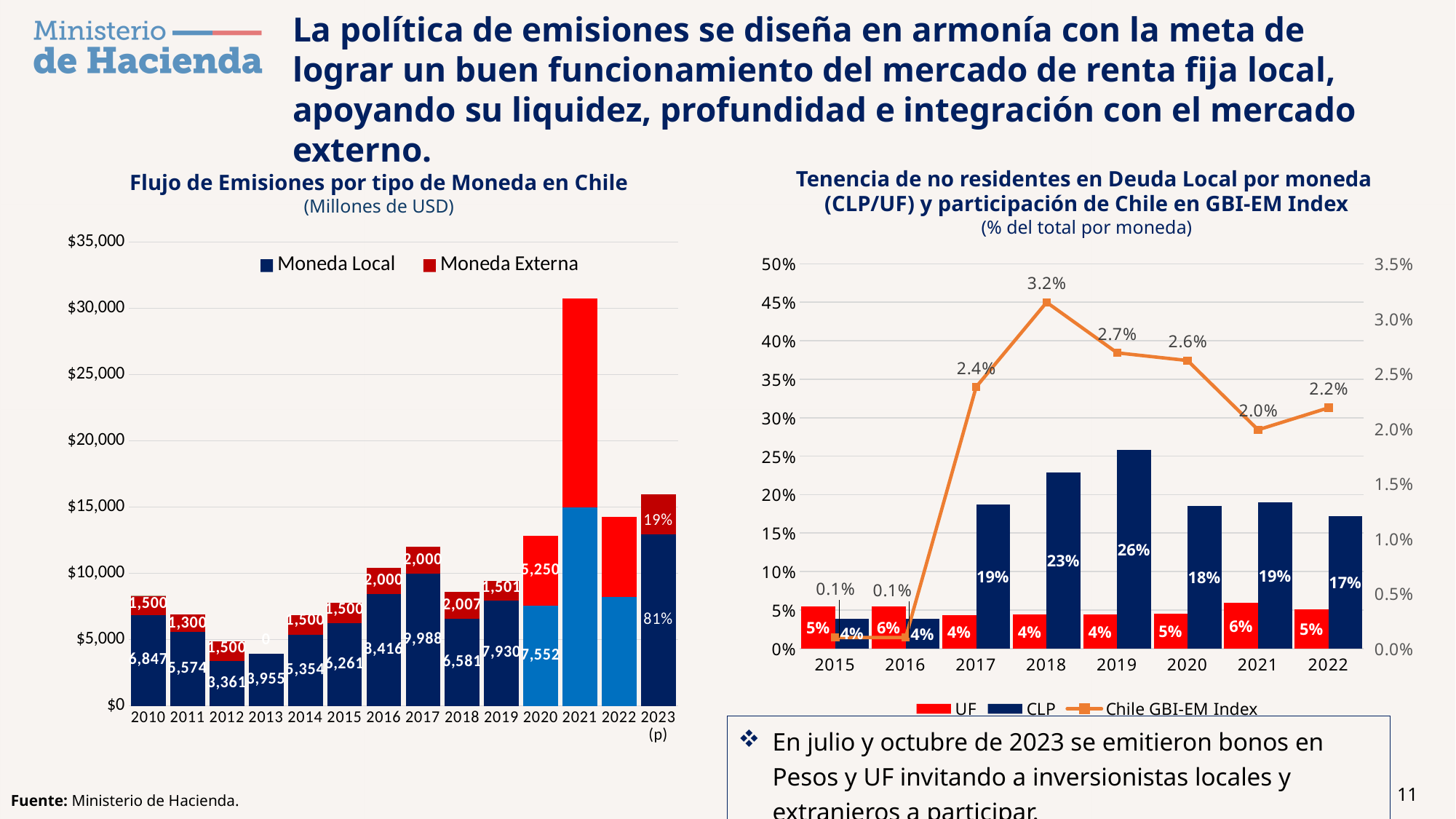
In the right chart (Tenencia de no residentes en Deuda Local), in which year does the Chile GBI-EM Index line reach its highest value? 2018 In the right chart (Tenencia de no residentes en Deuda Local), what is the UF value for 2021? 6% How many series does the legend of the right chart (Tenencia de no residentes en Deuda Local) list? 3 In the right chart (Tenencia de no residentes en Deuda Local), which year has the highest CLP value? 2019 In the left chart (Flujo de Emisiones por tipo de Moneda en Chile), what is the difference between the Moneda Local values for 2017 and 2016? 1,572 In the left chart (Flujo de Emisiones por tipo de Moneda en Chile), is the total for 2021 greater or less than $30,000? greater What kind of chart is the left chart (Flujo de Emisiones por tipo de Moneda en Chile)? Stacked bar chart In the right chart (Tenencia de no residentes en Deuda Local), which is larger, the Chile GBI-EM Index value for 2020 or for 2021? 2020 In the left chart (Flujo de Emisiones por tipo de Moneda en Chile), what is the Moneda Externa value for 2020? 5,250 In the left chart (Flujo de Emisiones por tipo de Moneda en Chile), what percentage label is shown for Moneda Local in 2023 (p)? 81% In the left chart (Flujo de Emisiones por tipo de Moneda en Chile), what is the Moneda Externa value for 2013? 0 In the left chart (Flujo de Emisiones por tipo de Moneda en Chile), what is the Moneda Local value for 2017? 9,988